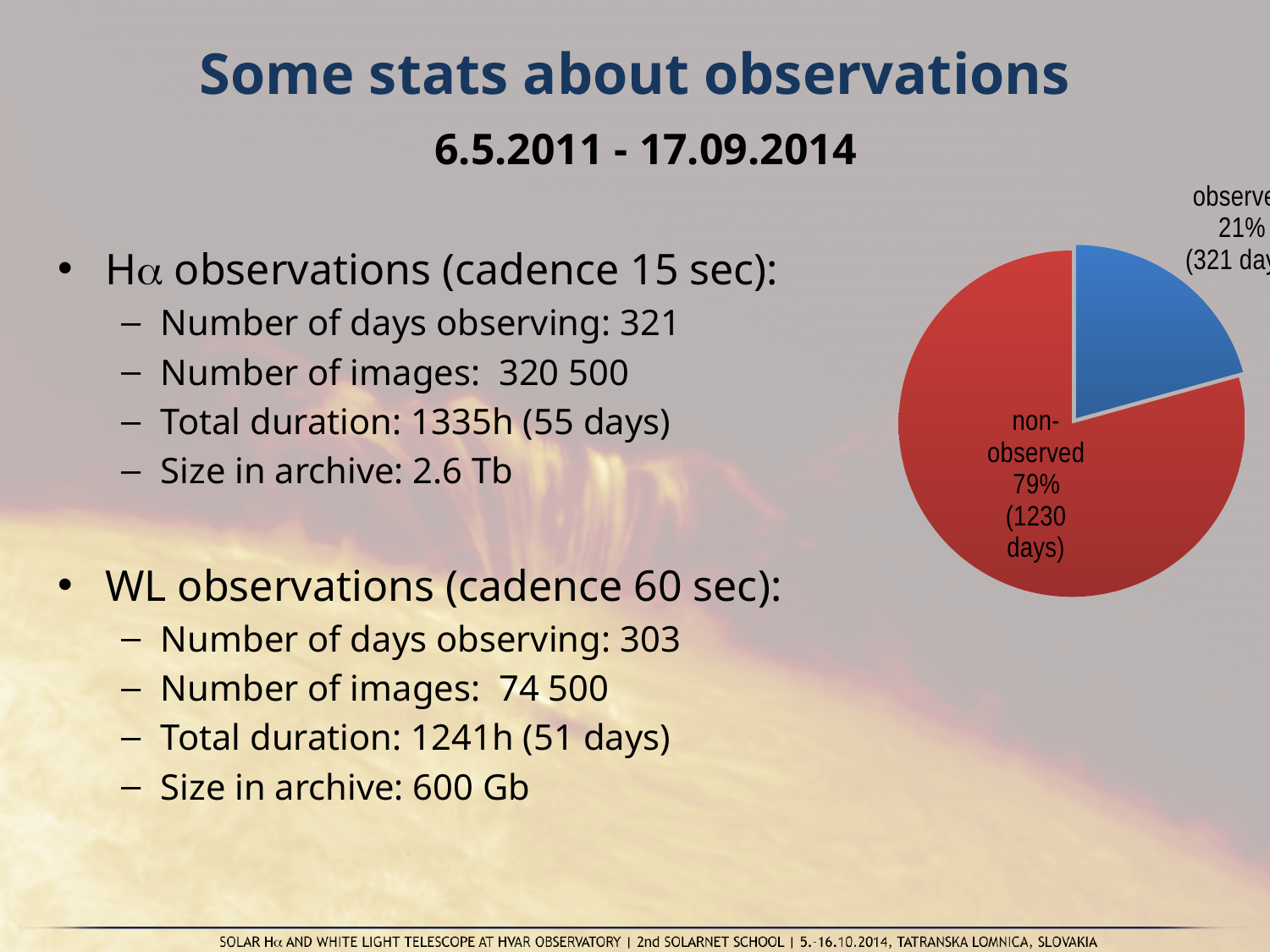
What is the difference in percentage points between the non-observed and observed slices of the pie chart? 58 How many days does the non-observed slice of the pie chart represent? 1230 days How many slices does the pie chart have? 2 What colour is the non-observed slice of the pie chart? red What kind of chart is shown on the slide? pie chart What percentage of the pie chart is labelled non-observed? 79% How many days does the observed slice of the pie chart represent? 321 days Which slice of the pie chart is the smallest? observed Which slice of the pie chart is the largest? non-observed Which is larger in the pie chart, the observed or the non-observed share? non-observed What percentage of the pie chart is labelled observed? 21% What is the difference in days between the non-observed and observed slices of the pie chart? 909 days